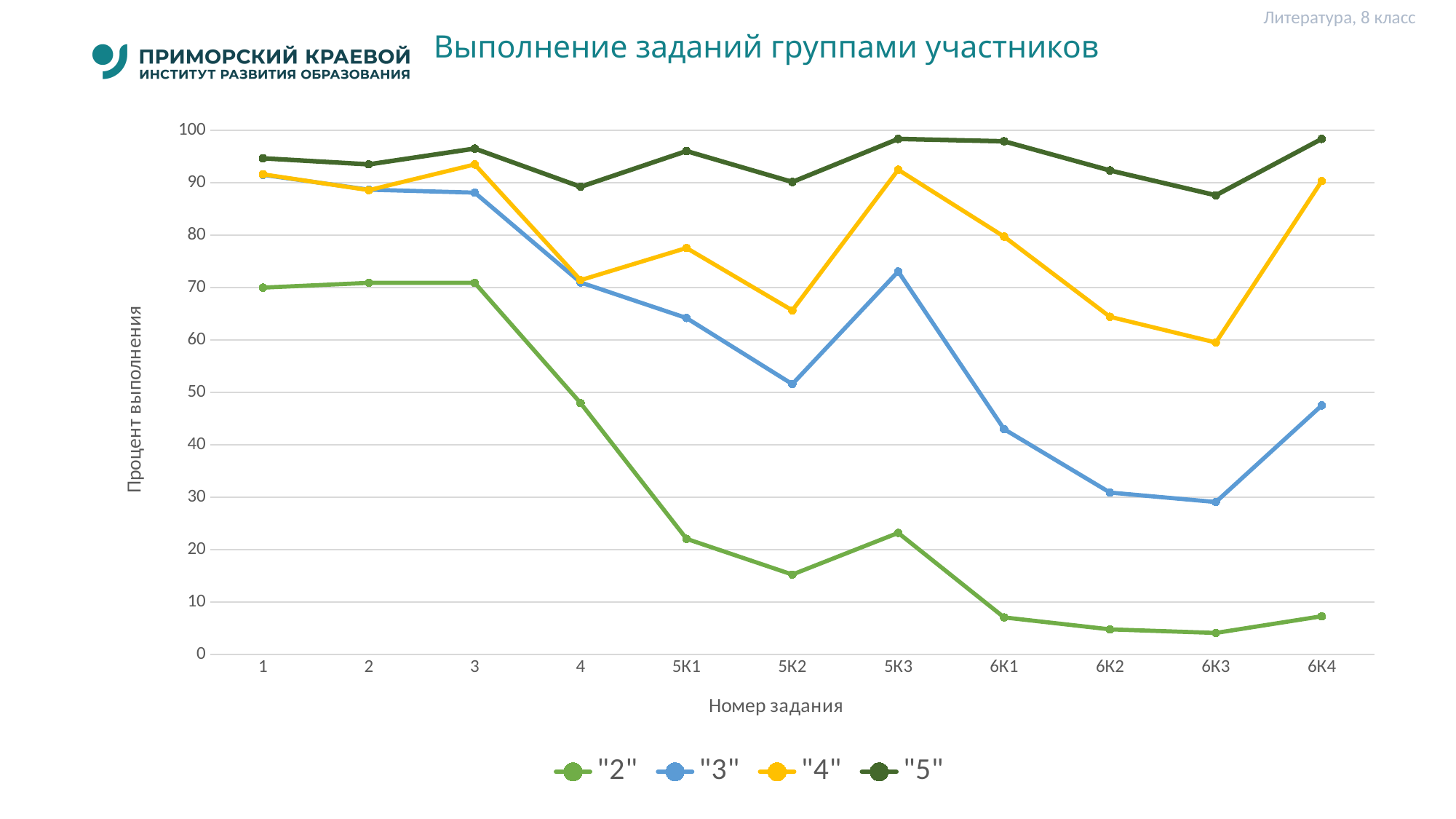
Which series has the highest value at task 6К4? "5" How many series does the legend list? 4 Does the value for series "2" rise or fall from task 3 to task 5К1? fall Is the value for series "2" at task 5К2 greater or less than 20? less What kind of chart is shown on the slide? line chart For series "4", at which task is the value lowest? 6К3 Is the value for series "3" at task 6К1 greater or less than 40? greater Is the value for series "5" at task 6К3 greater or less than 90? less At task 5К1, which series has the larger value, "3" or "4"? "4" How many task numbers are shown on the x axis? 11 What is the title of the chart? Выполнение заданий группами участников